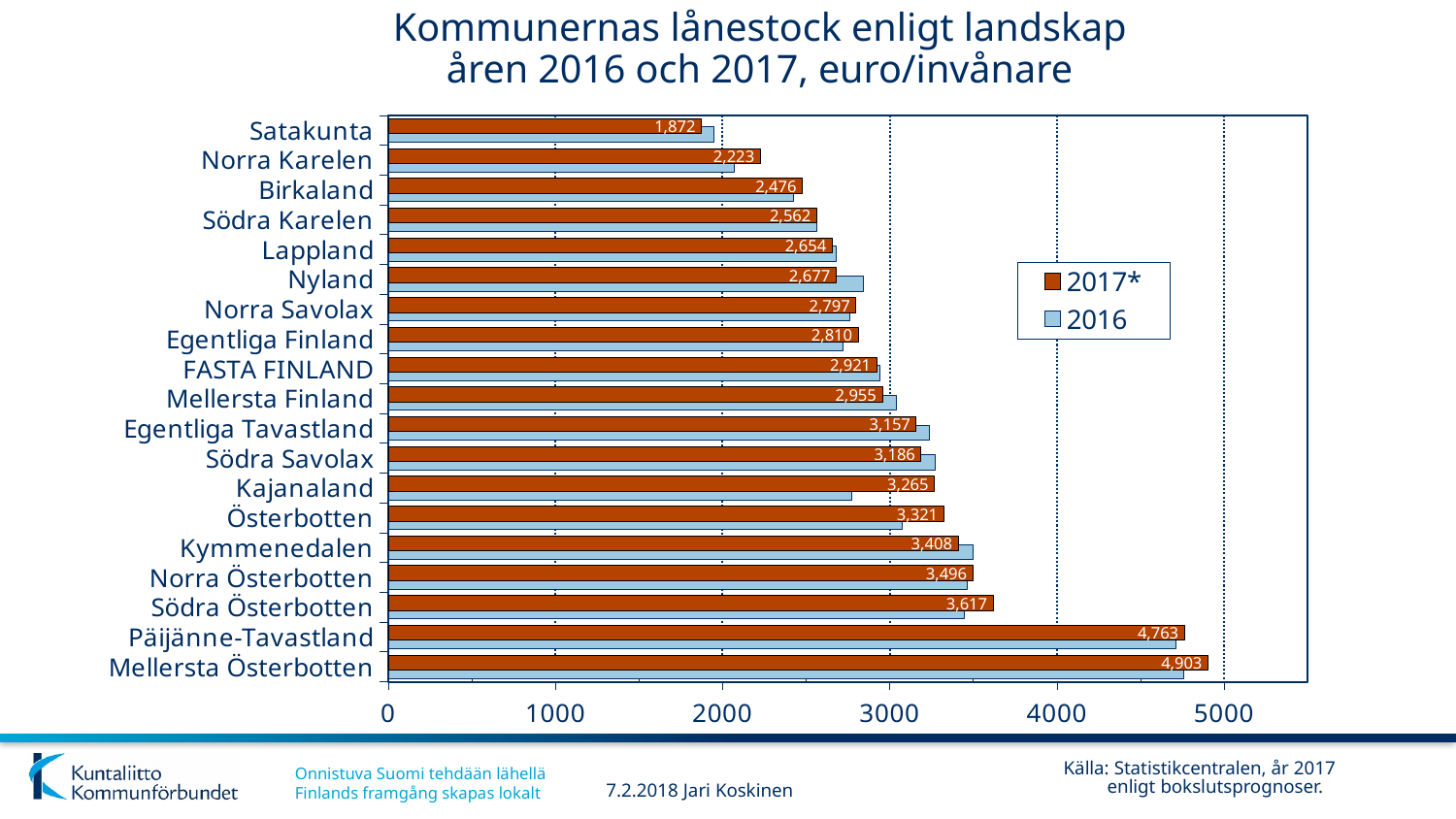
Which landskap has the highest 2017* value? Mellersta Österbotten What kind of chart is shown on the slide? Bar chart What is the difference between the 2017* values for Mellersta Österbotten and Päijänne-Tavastland? 140 Is the 2016 value for Satakunta greater or less than 2000? less How many series does the legend list? 2 What is the 2017* value for Nyland? 2,677 Which has a larger 2017* value, Kajanaland or Österbotten? Österbotten Is the 2016 value for Mellersta Österbotten greater or less than 4000? greater Which landskap has the lowest 2017* value? Satakunta How many landskap categories are shown on the chart? 19 What is the 2017* value for Satakunta? 1,872 What is the 2017* value for Päijänne-Tavastland? 4,763